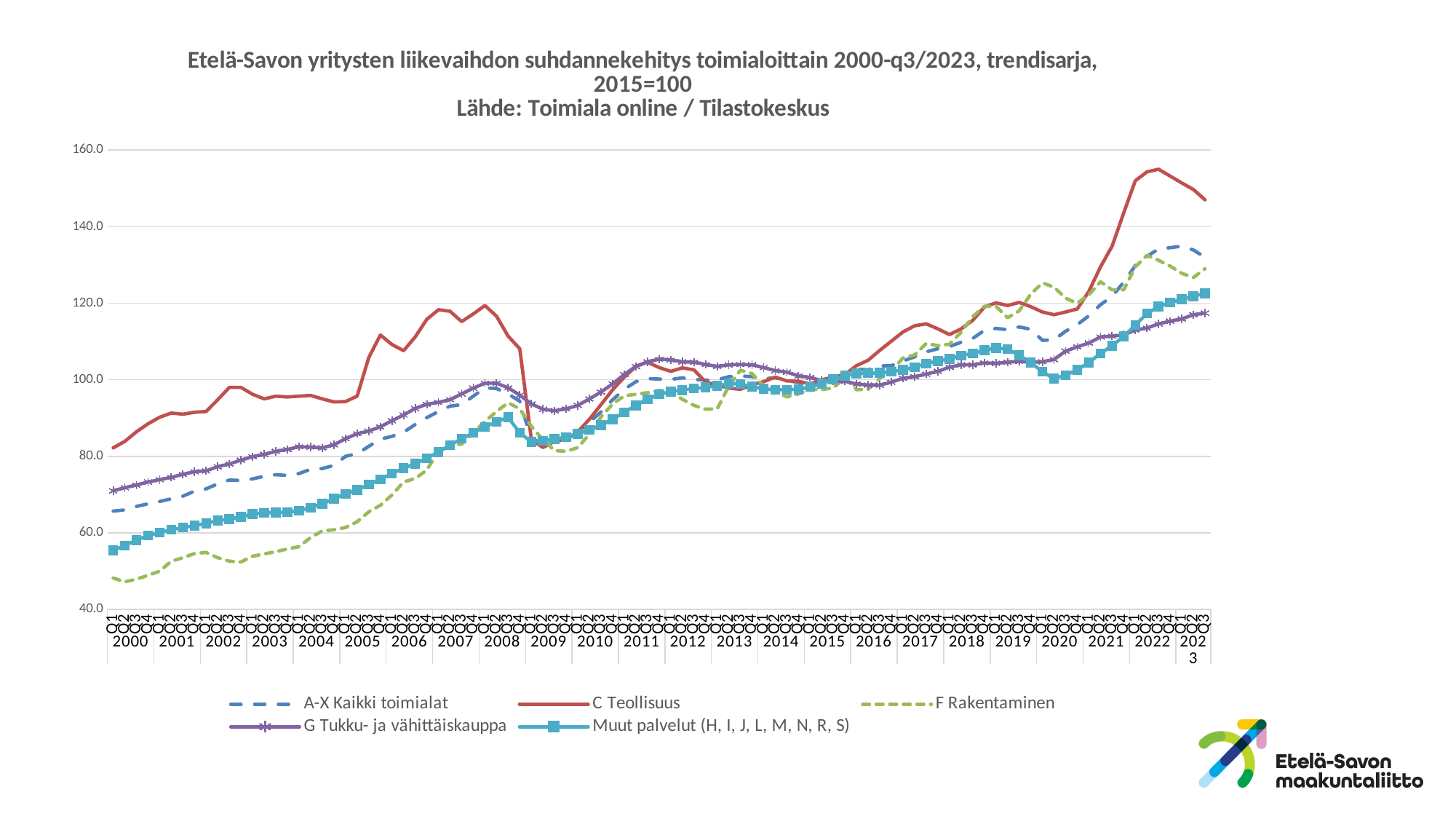
Does the Muut palvelut (H, I, J, L, M, N, R, S) series overall rise or fall from 2000 to 2023? rise In 2000 Q1, which series is higher: C Teollisuus or F Rakentaminen? C Teollisuus What kind of chart is shown on the slide? line chart Is the value for G Tukku- ja vähittäiskauppa in 2023 Q3 greater or less than 100? greater What base year and index value does the chart title state? 2015=100 Is the value for F Rakentaminen in 2000 Q1 greater or less than 60? less In 2023 Q3, which series is higher: A-X Kaikki toimialat or Muut palvelut (H, I, J, L, M, N, R, S)? A-X Kaikki toimialat Which series has the lowest value at the start of the chart in 2000? F Rakentaminen Which series is drawn with a solid red line? C Teollisuus Is the value for C Teollisuus in 2022 Q3 greater or less than 140? greater How many series does the legend list? 5 Which series reaches the highest value anywhere on the chart? C Teollisuus